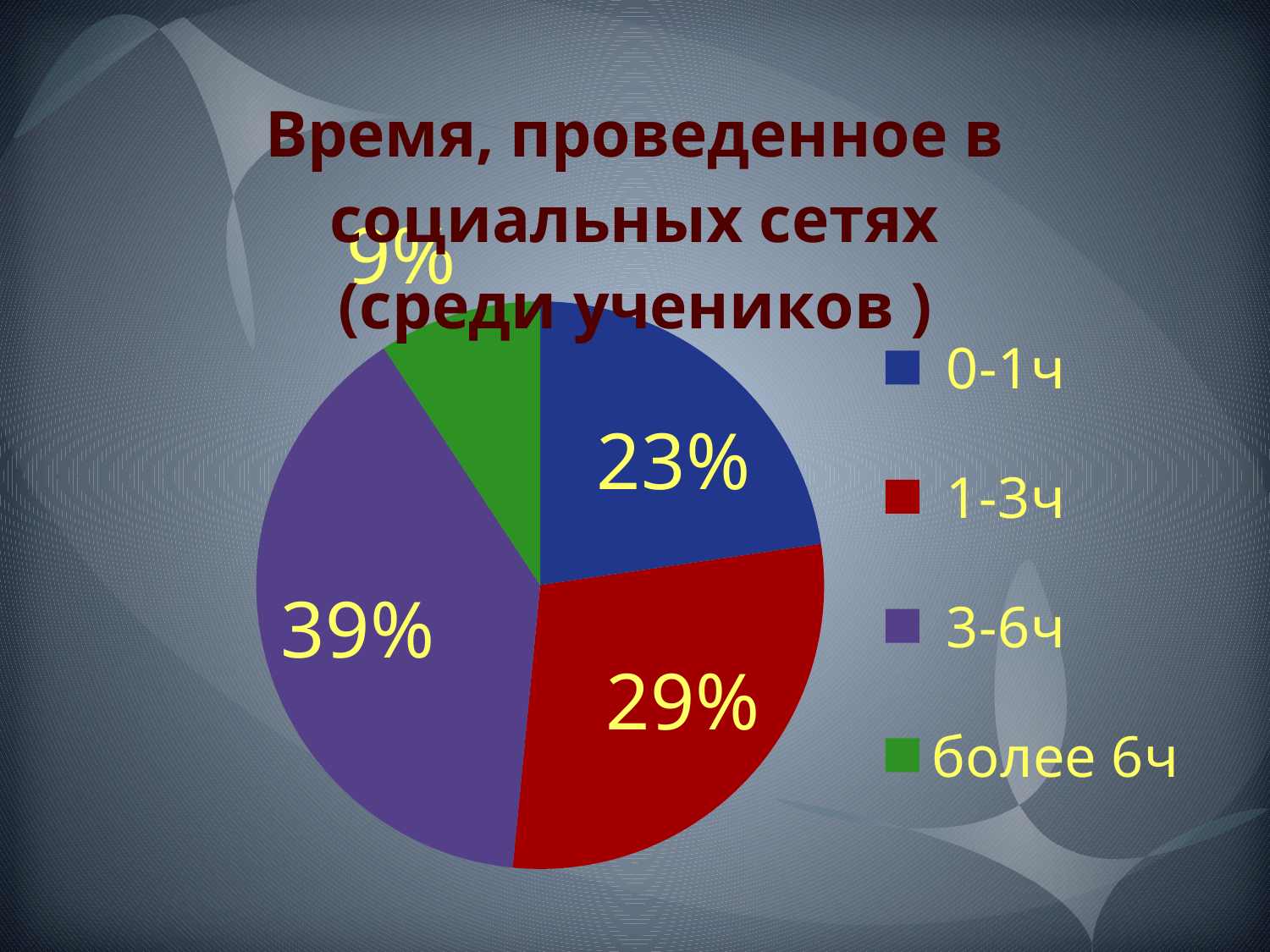
What kind of chart is shown on the slide? pie chart Which category has the smallest share of the pie? более 6ч What share of students spend 3-6ч in social networks? 39% Which is larger, the share for 1-3ч or the share for 0-1ч? 1-3ч What is the title of the chart? Время, проведенное в социальных сетях (среди учеников ) What share of students spend 1-3ч in social networks? 29% Which category has the largest share of the pie? 3-6ч How many categories does the pie chart show? 4 What share of students spend более 6ч in social networks? 9% What colour is the slice for 3-6ч? purple What is the difference in percentage points between the 3-6ч and 0-1ч slices? 16 What share of students spend 0-1ч in social networks? 23%